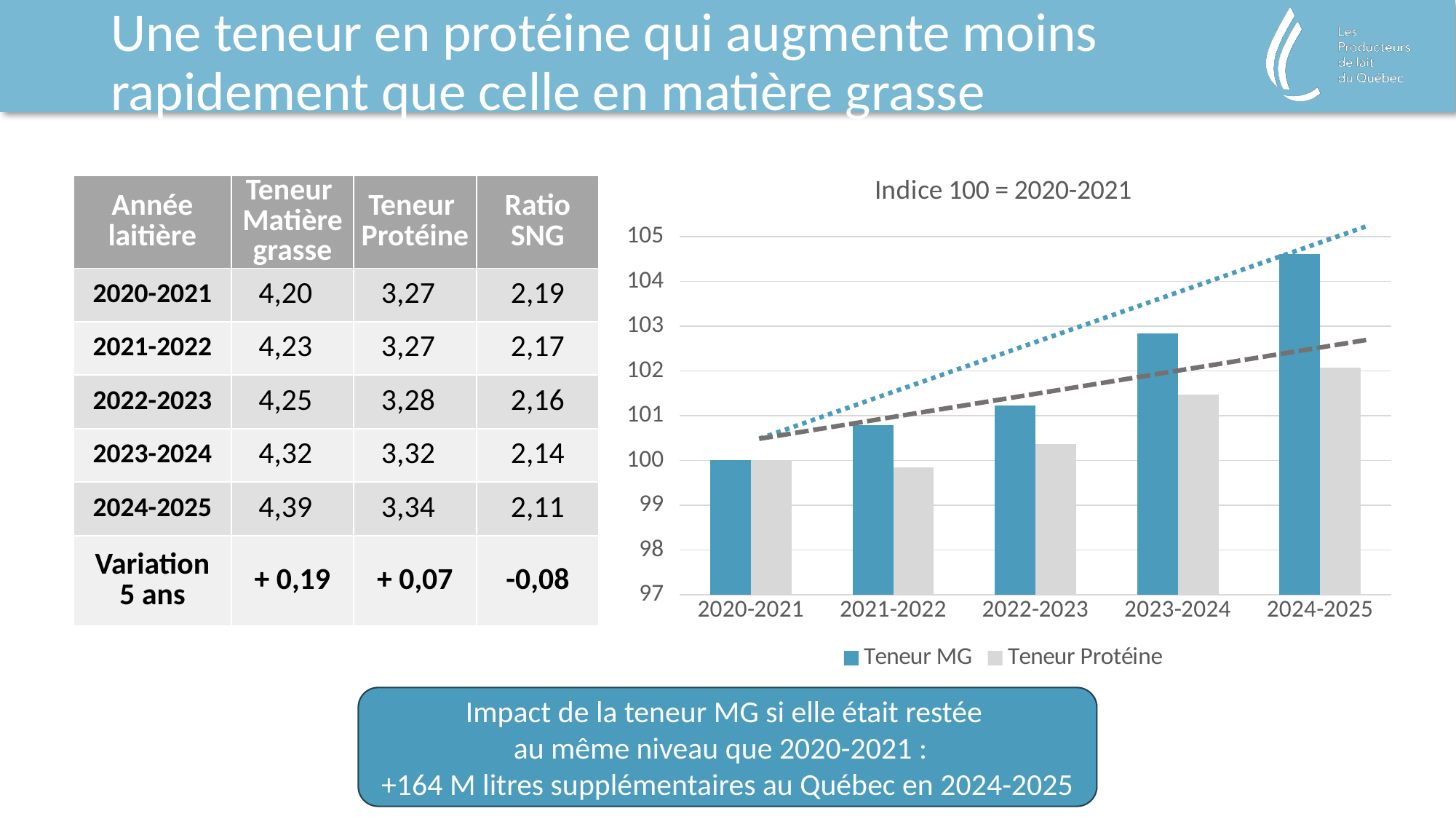
What is the index value of Teneur MG for 2020-2021 in the chart? 100 What is the title of the chart? Indice 100 = 2020-2021 Is the Teneur MG value for 2024-2025 greater or less than 104? greater In which year is the Teneur MG bar highest in the chart? 2024-2025 Is the Teneur MG value for 2023-2024 greater or less than 102? greater For 2024-2025, which is larger in the chart: Teneur MG or Teneur Protéine? Teneur MG How many dairy years are shown on the x axis of the chart? 5 Is the Teneur Protéine value for 2024-2025 greater or less than 103? less Do the Teneur MG values rise or fall from 2020-2021 to 2024-2025 in the chart? rise What kind of chart is shown on the slide? bar chart How many series does the chart legend list? 2